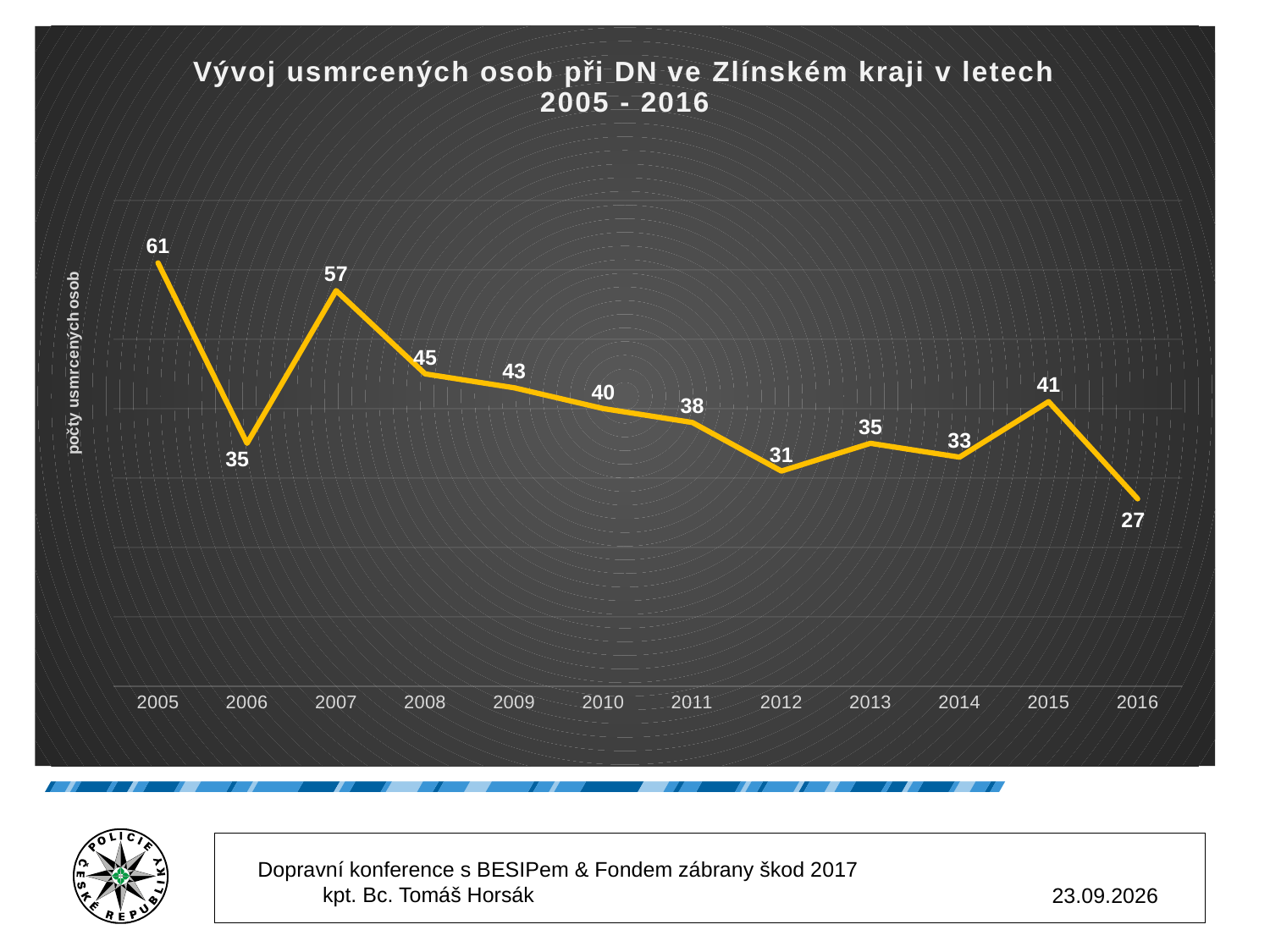
How many years are plotted on the chart? 12 What kind of chart is shown on the slide? line chart What was the number of people killed in traffic accidents in the Zlín region in 2005? 61 What is the difference between the values for 2005 and 2006? 26 What value is shown for 2016? 27 What is the difference between the values for 2015 and 2016? 14 Which year has the highest number of people killed? 2005 What value is shown for 2012? 31 Which year has a higher value, 2007 or 2008? 2007 Which year has a higher value, 2013 or 2014? 2013 Which year has the lowest number of people killed? 2016 Do the values generally rise or fall from 2007 to 2012? fall